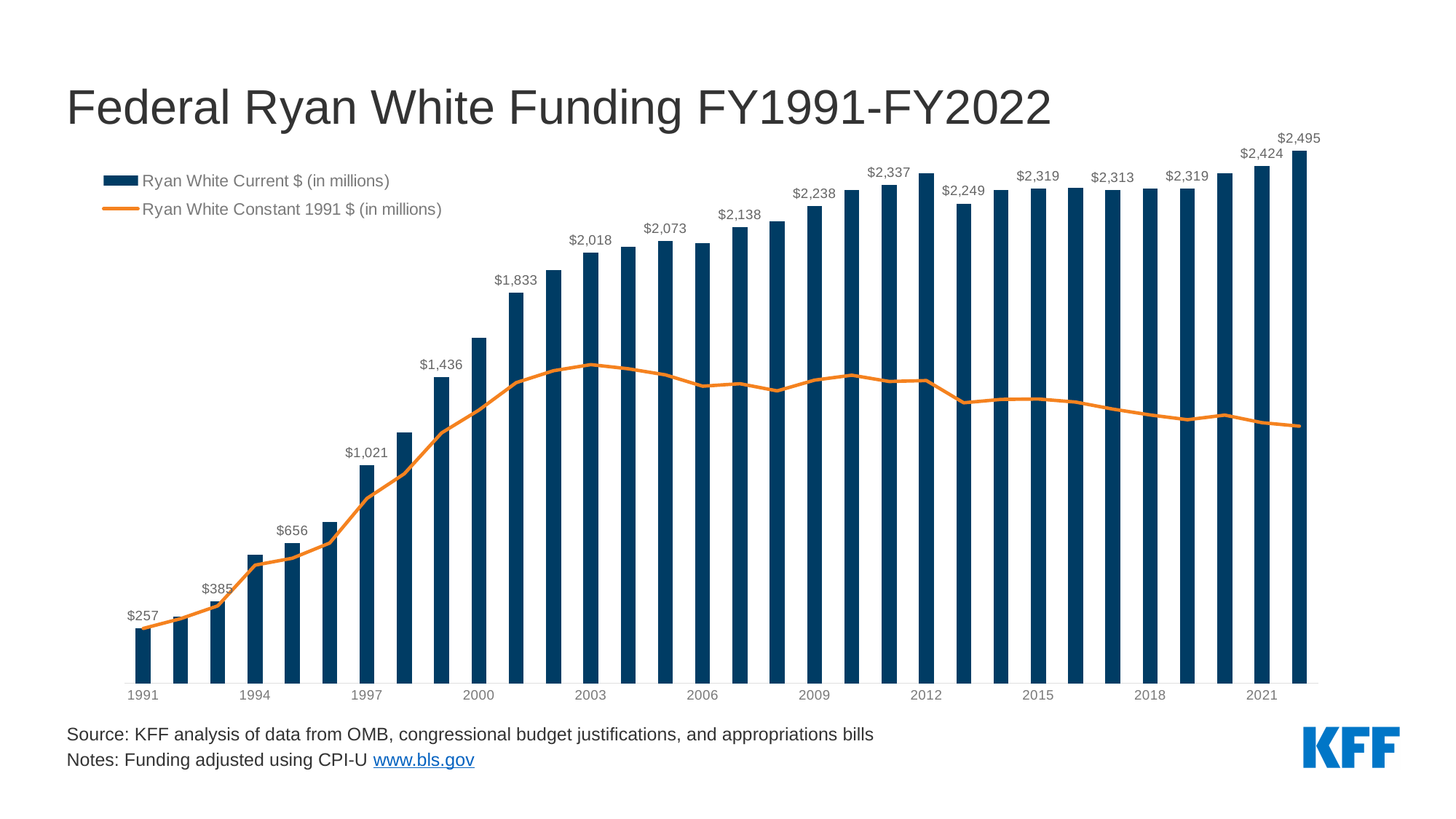
What is the Ryan White Current $ value for FY2011? $2,337 How many series does the legend list? 2 What is the Ryan White Current $ value for FY1991? $257 What is the Ryan White Current $ value for FY1999? $1,436 What is the Ryan White Current $ value for FY2022? $2,495 How many years (bars) are plotted for Ryan White Current $? 32 What is the difference between the Ryan White Current $ values for FY2022 and FY2021? $71 Which year has the lowest Ryan White Current $ value? 1991 Which is larger, the Ryan White Current $ value for FY2011 or for FY2013? FY2011 Which year has the highest Ryan White Current $ value? 2022 Does the Ryan White Current $ series generally rise or fall from 1991 to 2022? rise Which series is shown as an orange line? Ryan White Constant 1991 $ (in millions)